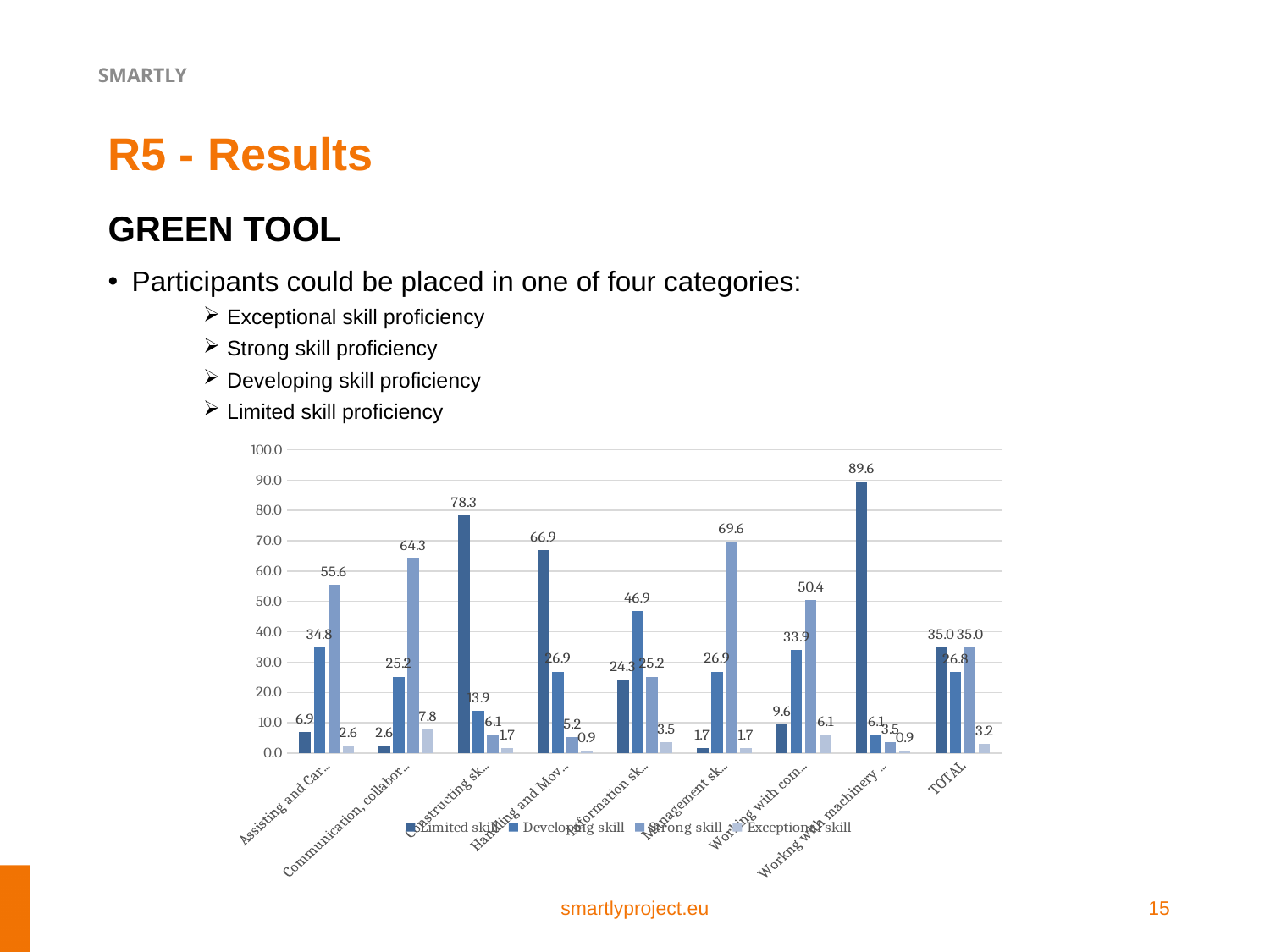
How many categories are shown along the x axis of the chart? 9 What kind of chart is shown on the slide? bar chart What is the highest value labelled anywhere in the chart? 89.6 Which series has the lowest value in the TOTAL category? Exceptional skill What is the value for Developing skill in the TOTAL category? 26.8 What are the four series listed in the chart legend? Limited skill, Developing skill, Strong skill, Exceptional skill Is the value for Developing skill in the TOTAL category greater or less than 30.0? less In the TOTAL category, which is larger: Developing skill or Exceptional skill? Developing skill What is the value for Exceptional skill in the TOTAL category? 3.2 What is the difference between the Limited skill and Developing skill values in the TOTAL category? 8.2 How many series does the chart legend list? 4 What is the value for Limited skill in the TOTAL category? 35.0